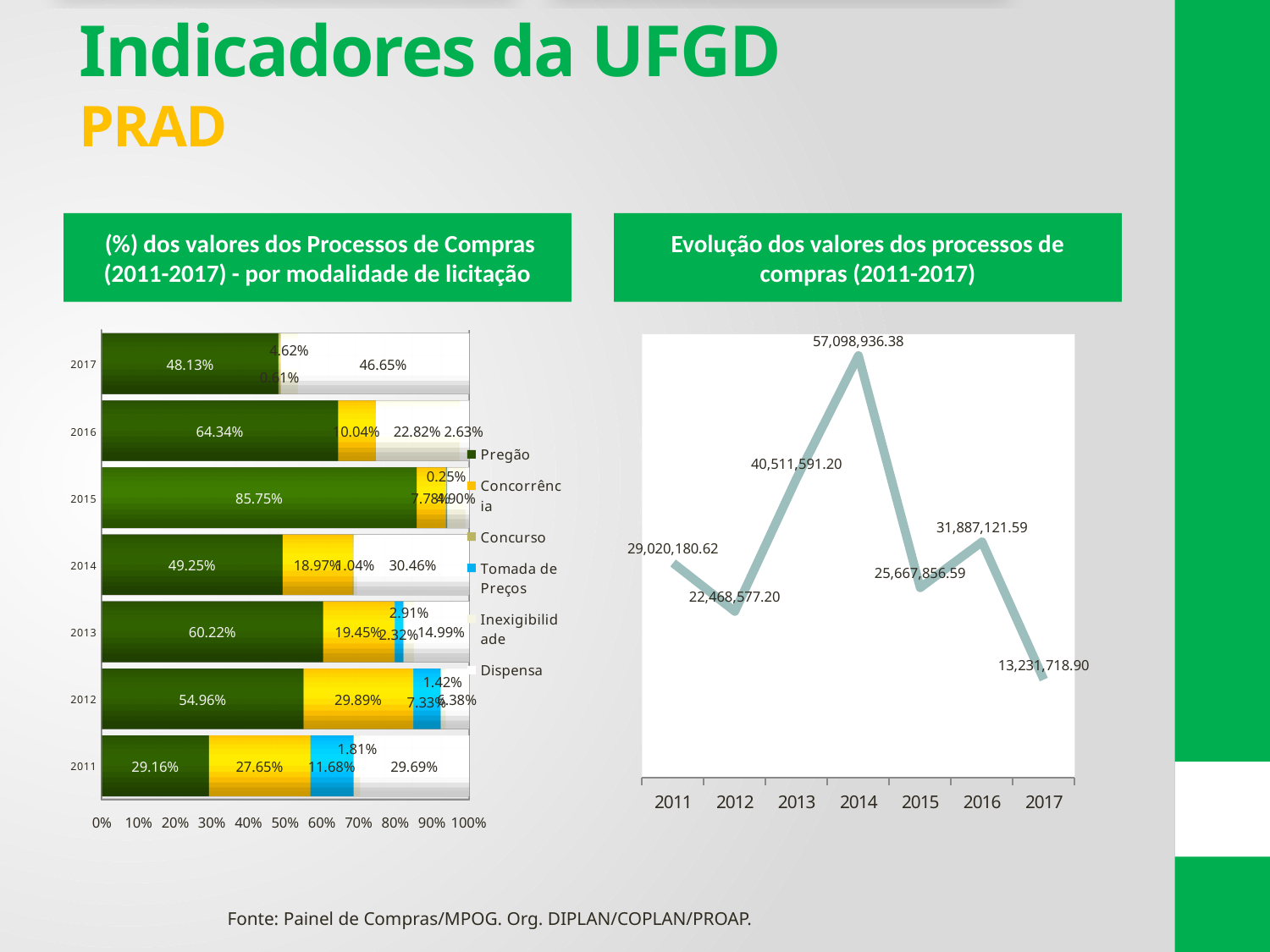
In the chart 'Evolução dos valores dos processos de compras (2011-2017)', which year has the lowest value? 2017 What kind of chart is 'Evolução dos valores dos processos de compras (2011-2017)'? Line chart In the chart 'Evolução dos valores dos processos de compras (2011-2017)', which is larger, the value for 2011 or for 2012? 2011 In the chart 'Evolução dos valores dos processos de compras (2011-2017)', which year has the highest value? 2014 In the chart 'Evolução dos valores dos processos de compras (2011-2017)', what is the difference between the 2014 and 2013 values? 16,587,345.18 In the chart '(%) dos valores dos Processos de Compras (2011-2017) - por modalidade de licitação', what is the Pregão share for 2015? 85.75% In the chart '(%) dos valores dos Processos de Compras (2011-2017) - por modalidade de licitação', which year has the highest Pregão share? 2015 In the chart '(%) dos valores dos Processos de Compras (2011-2017) - por modalidade de licitação', how many series does the legend list? 6 In the chart '(%) dos valores dos Processos de Compras (2011-2017) - por modalidade de licitação', what is the Pregão share for 2011? 29.16% What kind of chart is '(%) dos valores dos Processos de Compras (2011-2017) - por modalidade de licitação'? Stacked bar chart In the chart 'Evolução dos valores dos processos de compras (2011-2017)', what is the value for 2014? 57,098,936.38 In the chart '(%) dos valores dos Processos de Compras (2011-2017) - por modalidade de licitação', which year has the lowest Pregão share? 2011